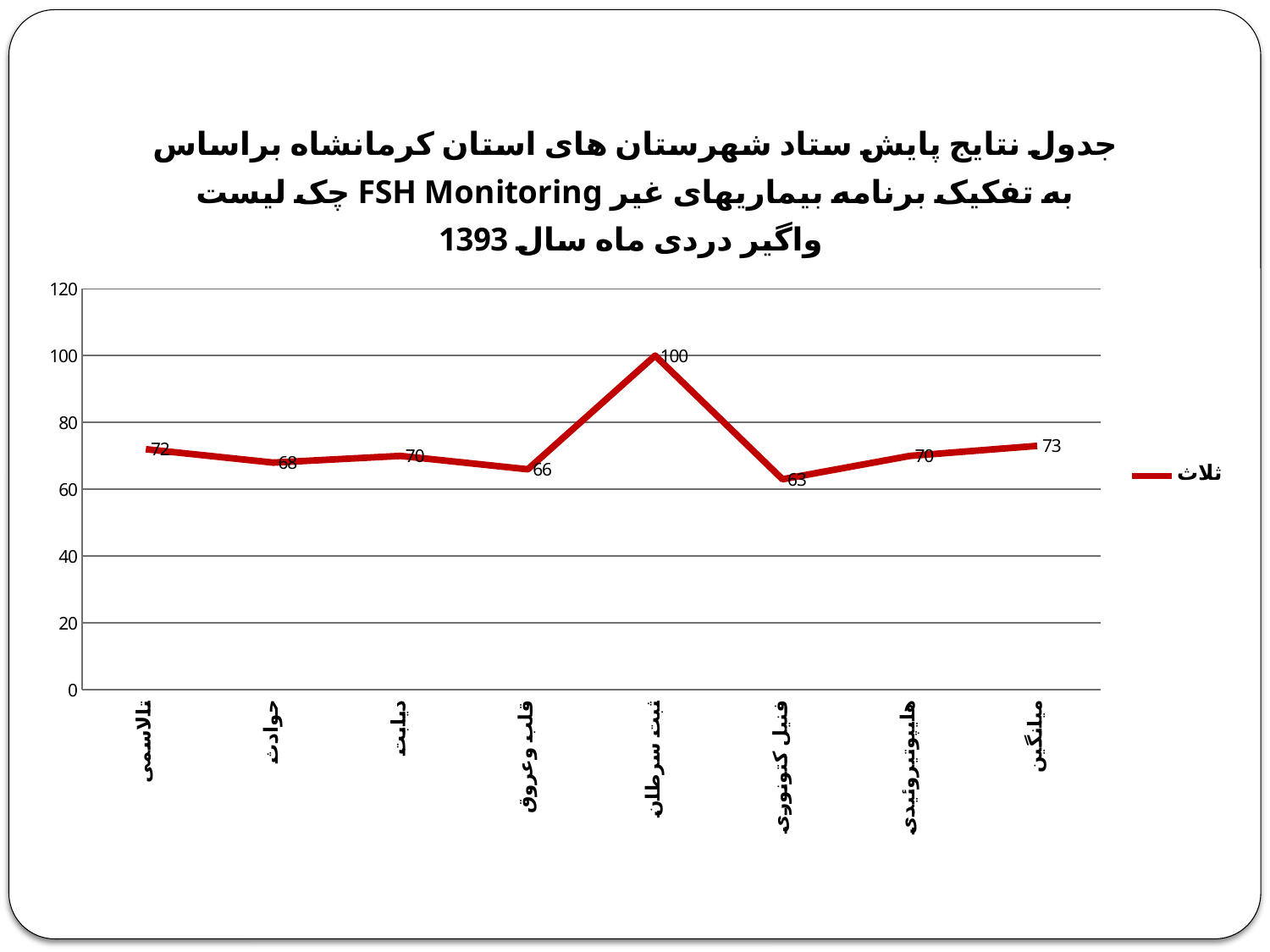
How many series does the legend list? 1 Which is larger, the value for حوادث or the value for قلب و عروق? حوادث What is the value for فنیل کتونوری? 63 What is the value for میانگین? 73 What is the name of the series shown in the legend? ثلاث How many categories are plotted on the x axis? 8 What is the difference between the values for ثبت سرطان and فنیل کتونوری? 37 Which category has the lowest value? فنیل کتونوری Which category has the highest value? ثبت سرطان What is the value for ثبت سرطان? 100 What kind of chart is shown? line chart What is the value for تالاسمی? 72